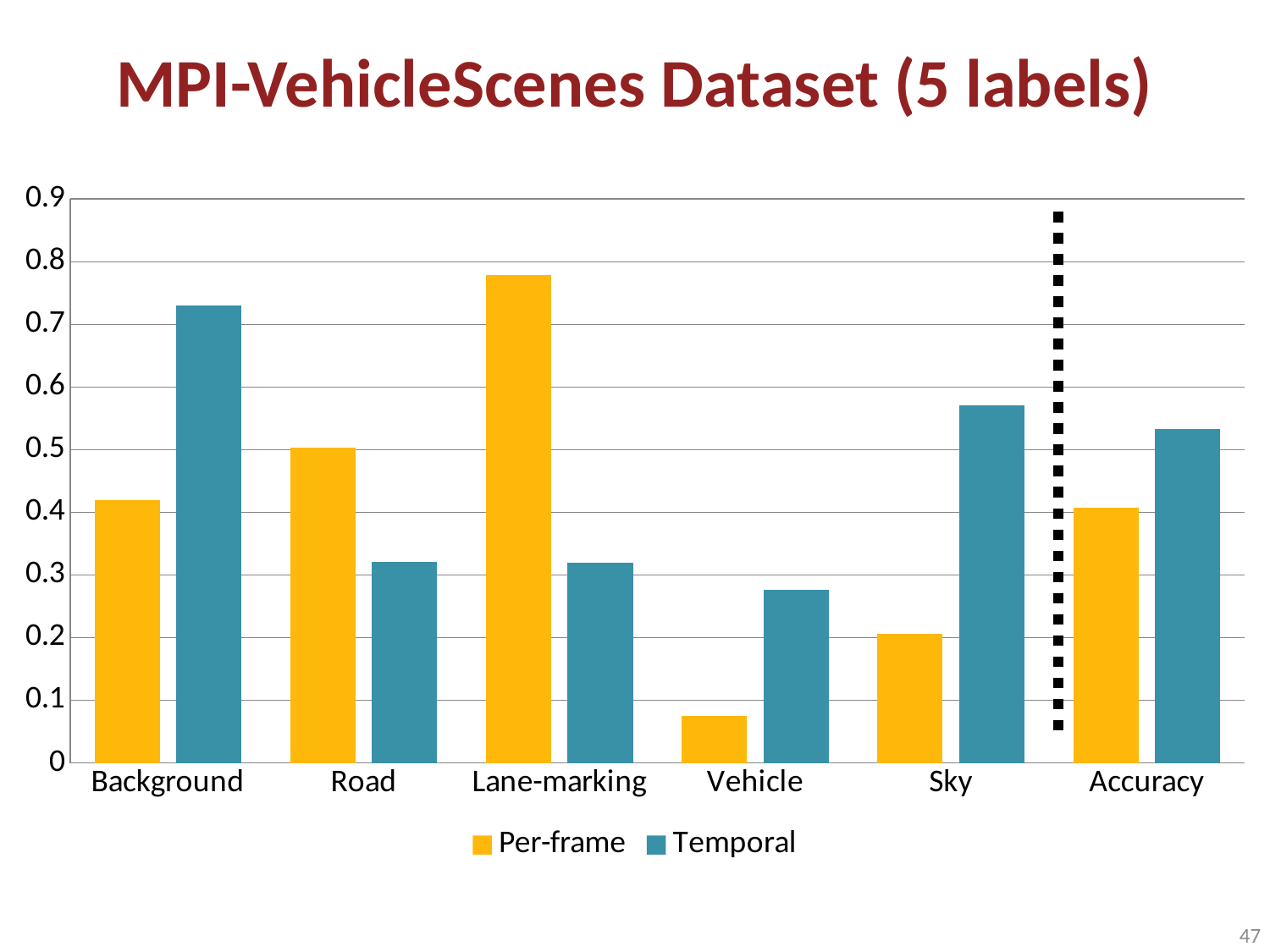
Which category has the lowest Per-frame value? Vehicle How many categories are shown on the x axis? 6 For Background, which is larger, the Per-frame value or the Temporal value? Temporal Is the Per-frame value for Vehicle greater or less than 0.1? less Is the Temporal value for Sky greater or less than 0.5? greater What is the title of the chart? MPI-VehicleScenes Dataset (5 labels) Which category has the highest Per-frame value? Lane-marking Which category has the highest Temporal value? Background Which category has the lowest Temporal value? Vehicle How many series does the legend list? 2 For Road, which is larger, the Per-frame value or the Temporal value? Per-frame What kind of chart is shown on the slide? bar chart